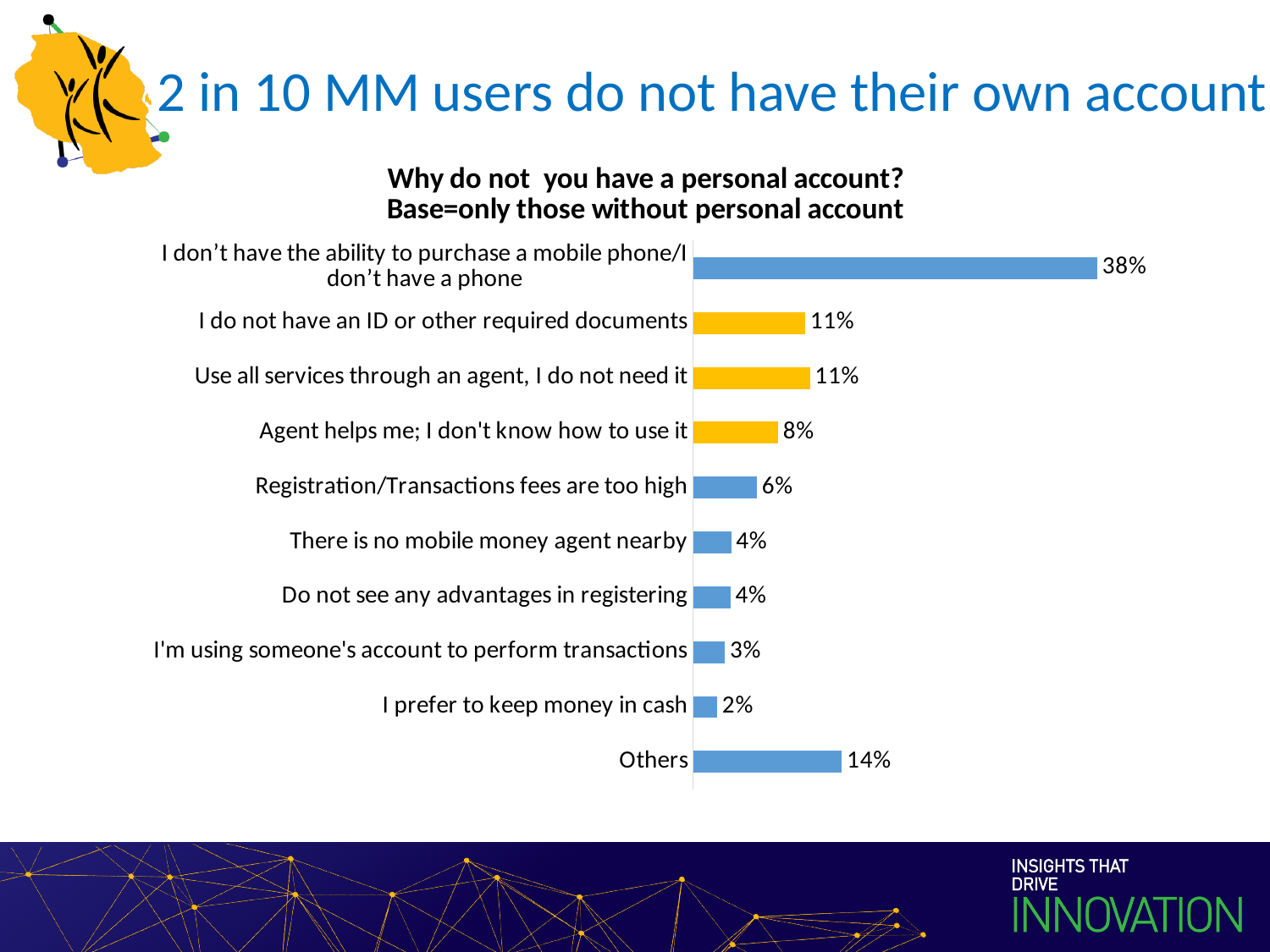
Which reason has the highest percentage? I don't have the ability to purchase a mobile phone/I don't have a phone What percentage of respondents said they don't have the ability to purchase a mobile phone / don't have a phone? 38% What type of chart is shown on the slide? Bar chart What percentage of respondents gave 'Others' as their reason? 14% Which reason has the lowest percentage? I prefer to keep money in cash How many reasons (categories) are shown in the chart? 10 What is the title of the chart? Why do not you have a personal account? Base=only those without personal account What is the difference in percentage points between 'I don't have the ability to purchase a mobile phone/I don't have a phone' and 'Others'? 24 What percentage of respondents said registration/transaction fees are too high? 6% Which is larger: the percentage for 'Agent helps me; I don't know how to use it' or for 'There is no mobile money agent nearby'? Agent helps me; I don't know how to use it What percentage of respondents said they do not have an ID or other required documents? 11% What percentage of respondents said they prefer to keep money in cash? 2%